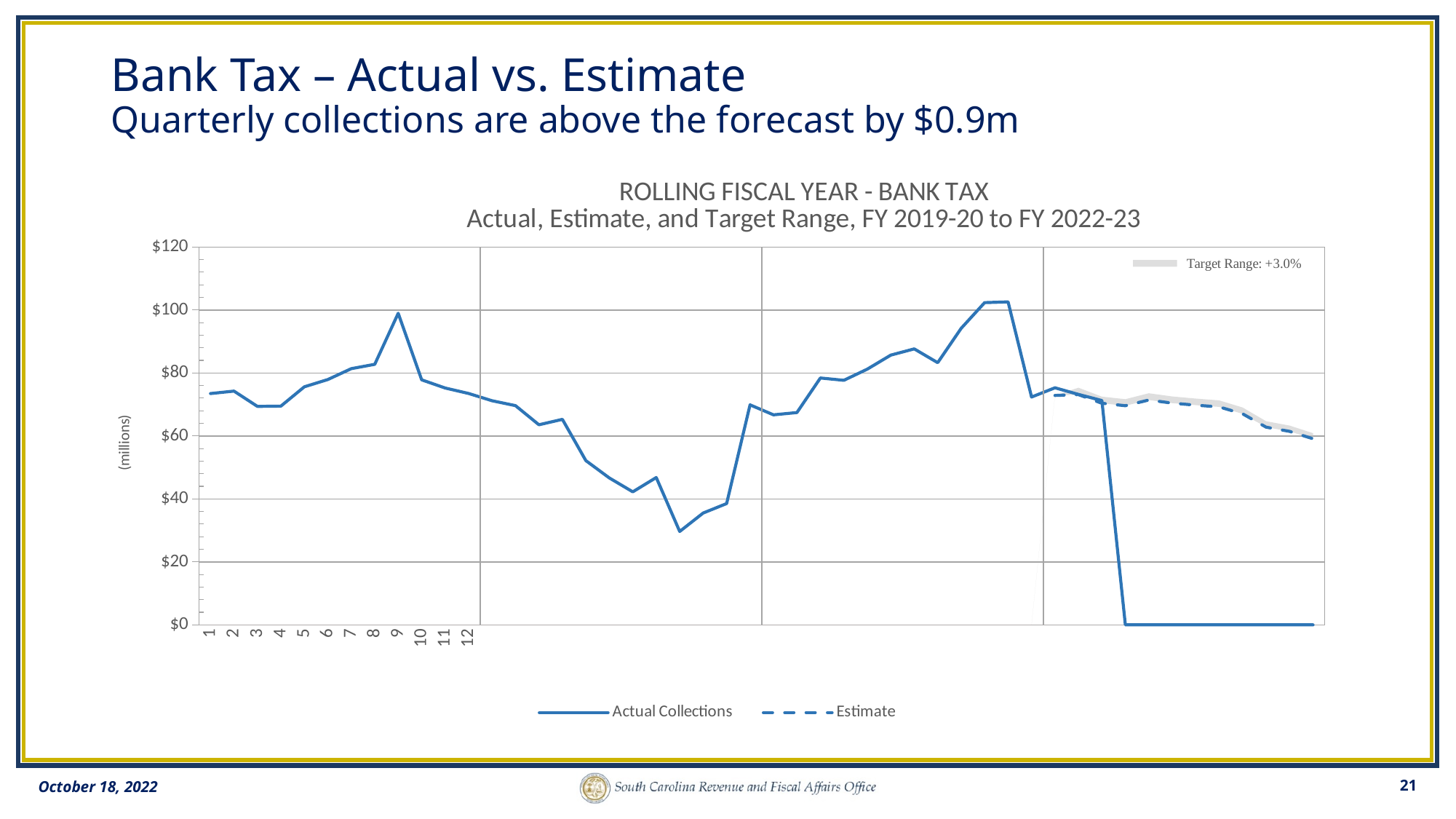
How many series does the legend at the bottom of the chart list? 2 Is the highest point of the Actual Collections line in the third fiscal year greater or less than $80? greater What is the title of the chart? ROLLING FISCAL YEAR - BANK TAX Actual, Estimate, and Target Range, FY 2019-20 to FY 2022-23 Is the lowest point of the Actual Collections line in the second fiscal year greater or less than $40? less Do Actual Collections rise or fall from month 9 to month 12 of the first fiscal year? fall Is the value of Actual Collections at month 1 of the first fiscal year greater or less than $60? greater Which is larger: Actual Collections at month 9 of the first fiscal year or at month 4 of the first fiscal year? Month 9 What is the highest value shown on the y axis? $120 What are the two series named in the legend at the bottom of the chart? Actual Collections and Estimate Does the Estimate line rise or fall across the last fiscal year shown? fall What kind of chart is shown on the slide? Line chart